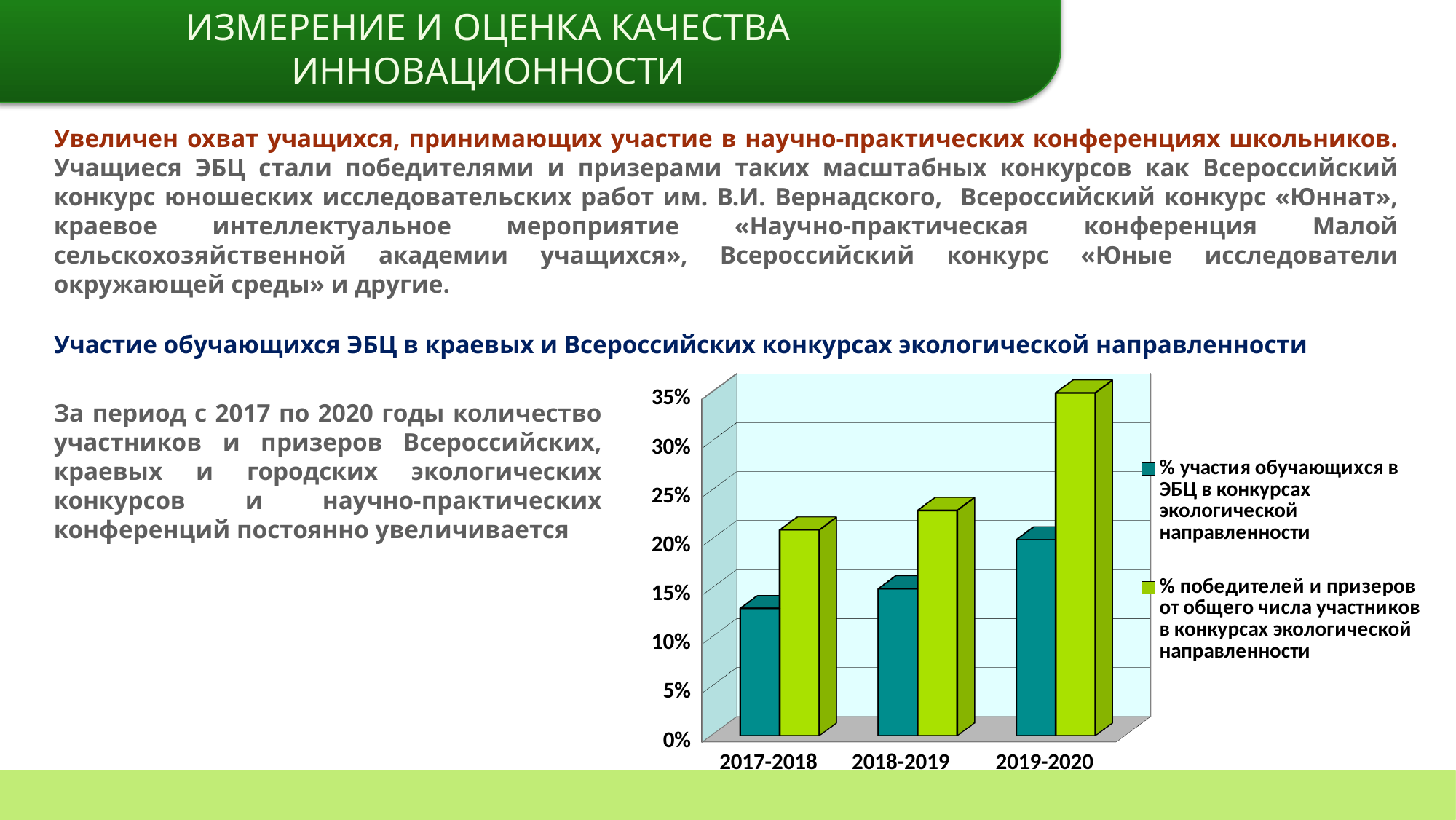
In 2019-2020, which series has the larger value: '% участия обучающихся в ЭБЦ' or '% победителей и призеров'? % победителей и призеров Is the value for '% победителей и призеров' in 2019-2020 greater or less than 30%? greater How many series does the chart legend list? 2 Which period has the highest value for '% победителей и призеров от общего числа участников в конкурсах экологической направленности'? 2019-2020 Is the value for '% участия обучающихся в ЭБЦ' in 2019-2020 greater or less than 15%? greater Do the values for '% участия обучающихся в ЭБЦ в конкурсах экологической направленности' rise or fall from 2017-2018 to 2019-2020? rise What kind of chart is shown on the slide? bar chart How many categories (periods) are shown on the x axis of the chart? 3 Is the value for '% победителей и призеров' in 2018-2019 greater or less than 25%? less What colour are the bars for '% победителей и призеров от общего числа участников' in the chart? light green Which period has the lowest value for '% участия обучающихся в ЭБЦ в конкурсах экологической направленности'? 2017-2018